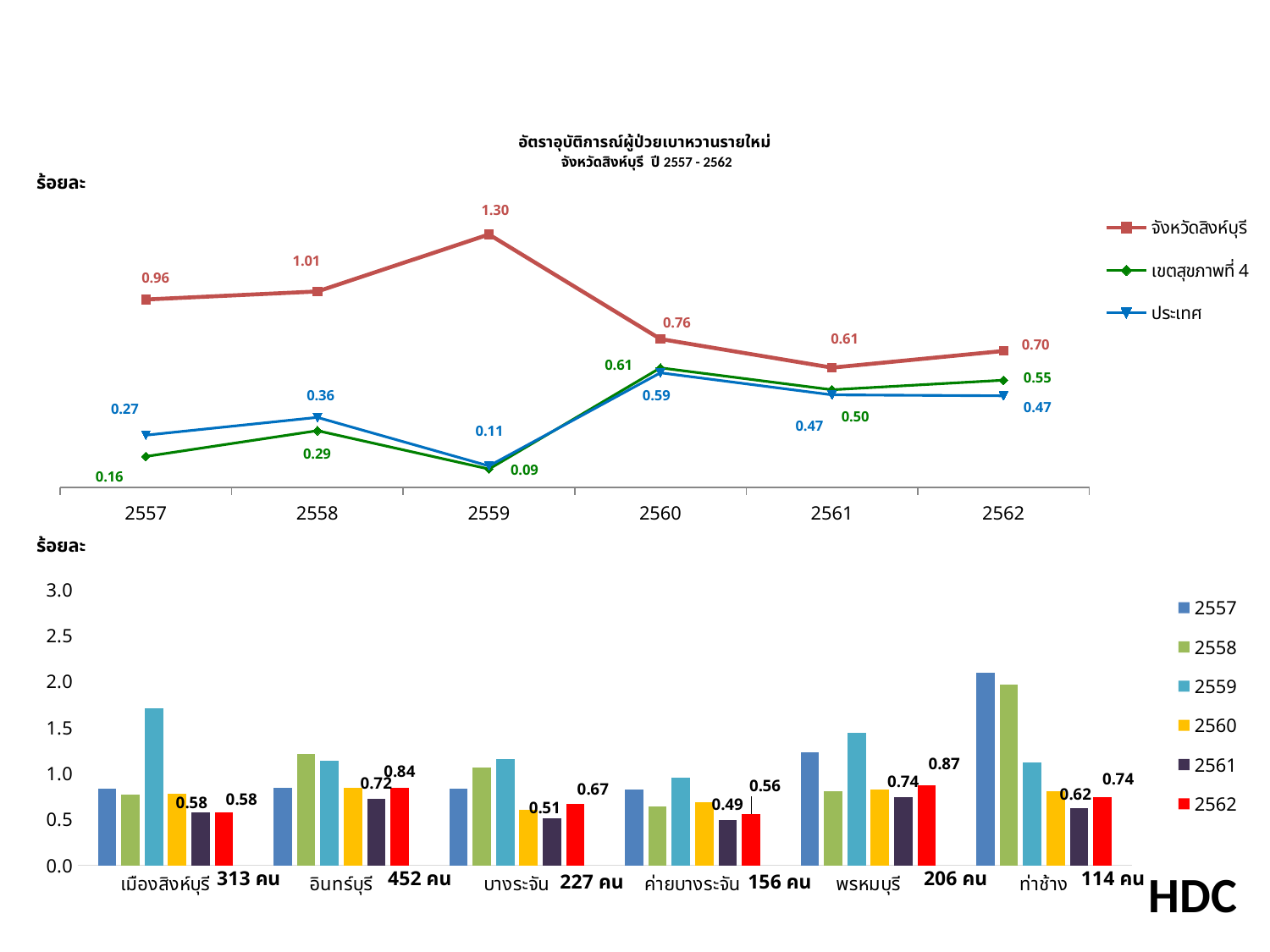
In the top line chart, what is the value for จังหวัดสิงห์บุรี in 2559? 1.30 In the bottom bar chart, is the 2559 value for เมืองสิงห์บุรี greater or less than 1.5? greater In the top line chart, what is the value for ประเทศ in 2558? 0.36 In the bottom bar chart, what is the value for พรหมบุรี in 2562? 0.87 In the top line chart, what is the value for เขตสุขภาพที่ 4 in 2561? 0.50 In the bottom bar chart, how many districts are shown on the x axis? 6 In the top line chart, how many series does the legend list? 3 In the top line chart, in which year is the จังหวัดสิงห์บุรี series highest? 2559 In the top line chart, in which year is the เขตสุขภาพที่ 4 series lowest? 2559 In the bottom bar chart, which is larger for อินทร์บุรี: the 2561 value or the 2562 value? 2562 In the top line chart, what is the difference between จังหวัดสิงห์บุรี and ประเทศ in 2557? 0.69 In the top line chart, does the จังหวัดสิงห์บุรี series rise or fall from 2559 to 2561? fall